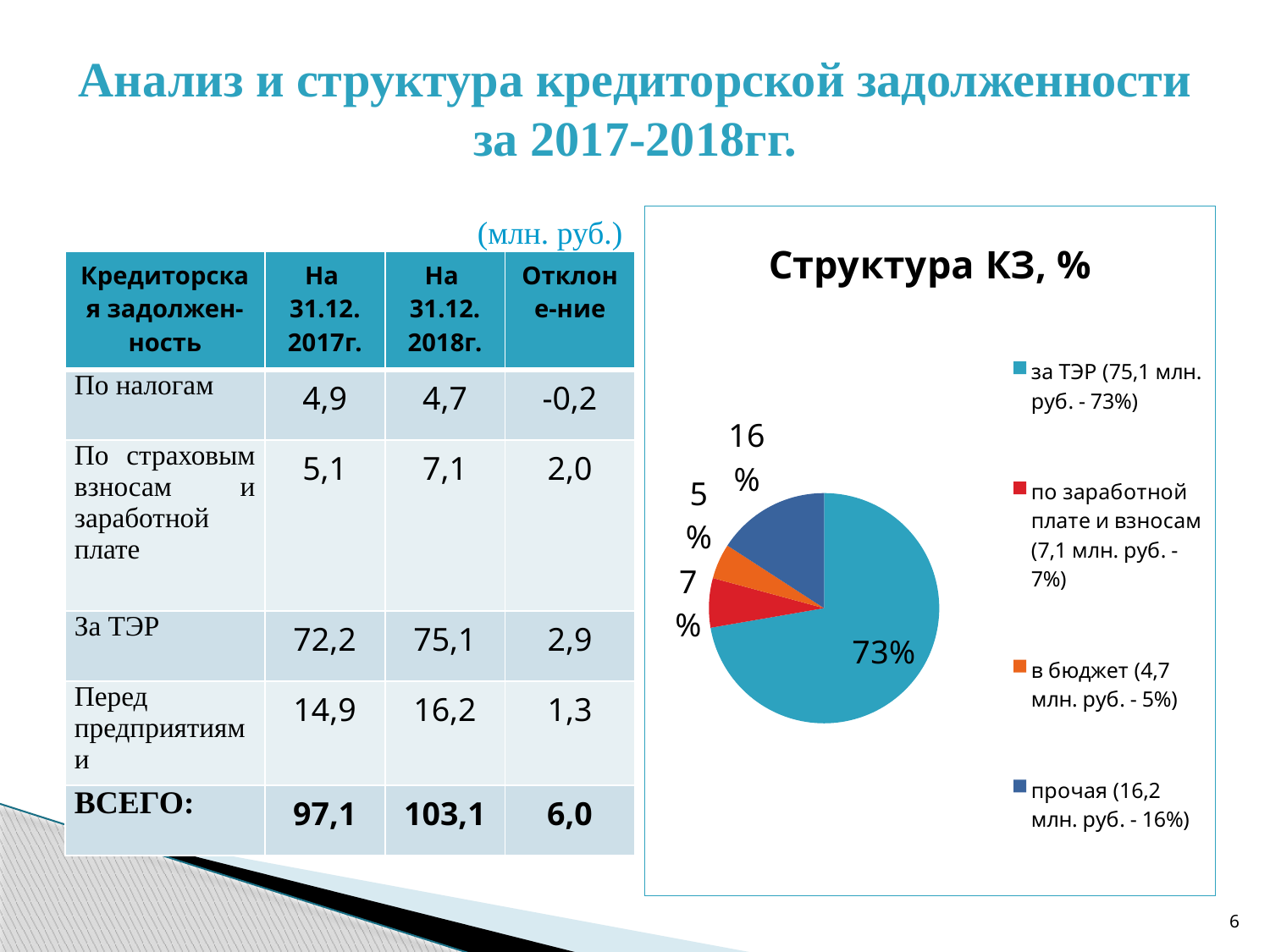
Which slice of the pie chart is the smallest? в бюджет How many slices does the pie chart have? 4 Which slice of the pie chart is the largest? за ТЭР What share of the pie does the slice 'в бюджет' represent? 5% How many entries does the chart legend list? 4 What is the difference in percentage points between the 'за ТЭР' slice and the 'прочая' slice? 57 What share of the pie does the slice 'по заработной плате и взносам' represent? 7% What share of the pie does the slice 'прочая' represent? 16% What is the title of the chart? Структура КЗ, % Which slice is larger: 'прочая' or 'по заработной плате и взносам'? прочая What type of chart is shown on the slide? pie chart